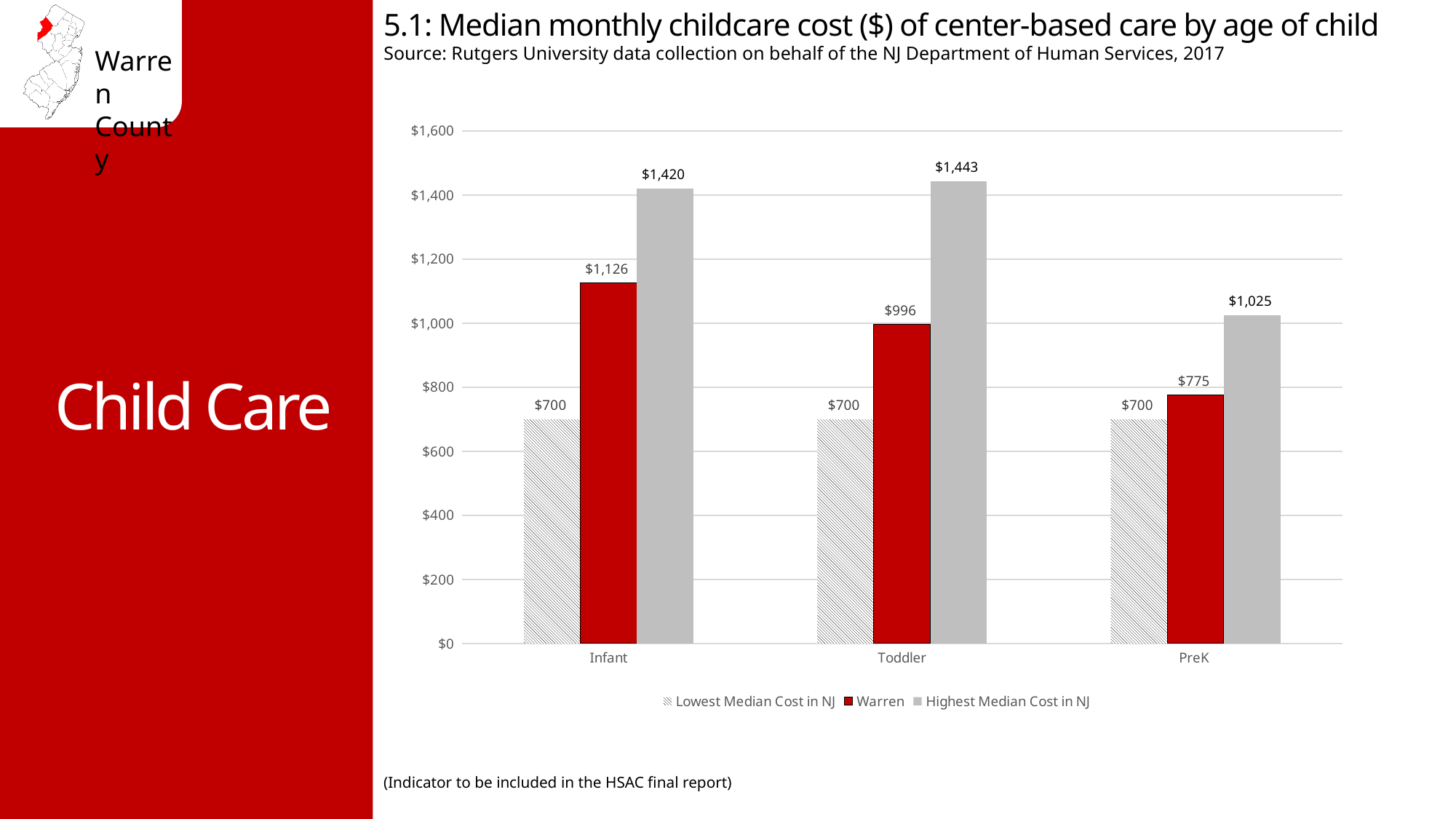
What is the Warren median monthly childcare cost for Infant care? $1,126 What is the Highest Median Cost in NJ for Toddler care? $1,443 How many age groups are shown on the x axis? 3 What is the difference between the Highest Median Cost in NJ and the Warren cost for PreK care? $250 What is the Lowest Median Cost in NJ for PreK care? $700 Does the Warren median monthly cost rise or fall from Infant to PreK? Fall Which is larger: the Warren cost for Toddler care or the Highest Median Cost in NJ for PreK care? Highest Median Cost in NJ for PreK care What kind of chart is shown on the slide? Bar chart Which age group has the lowest Highest Median Cost in NJ? PreK What is the difference between the Warren cost for Infant care and the Warren cost for Toddler care? $130 How many series does the legend list? 3 Which age group has the highest Warren median monthly cost? Infant